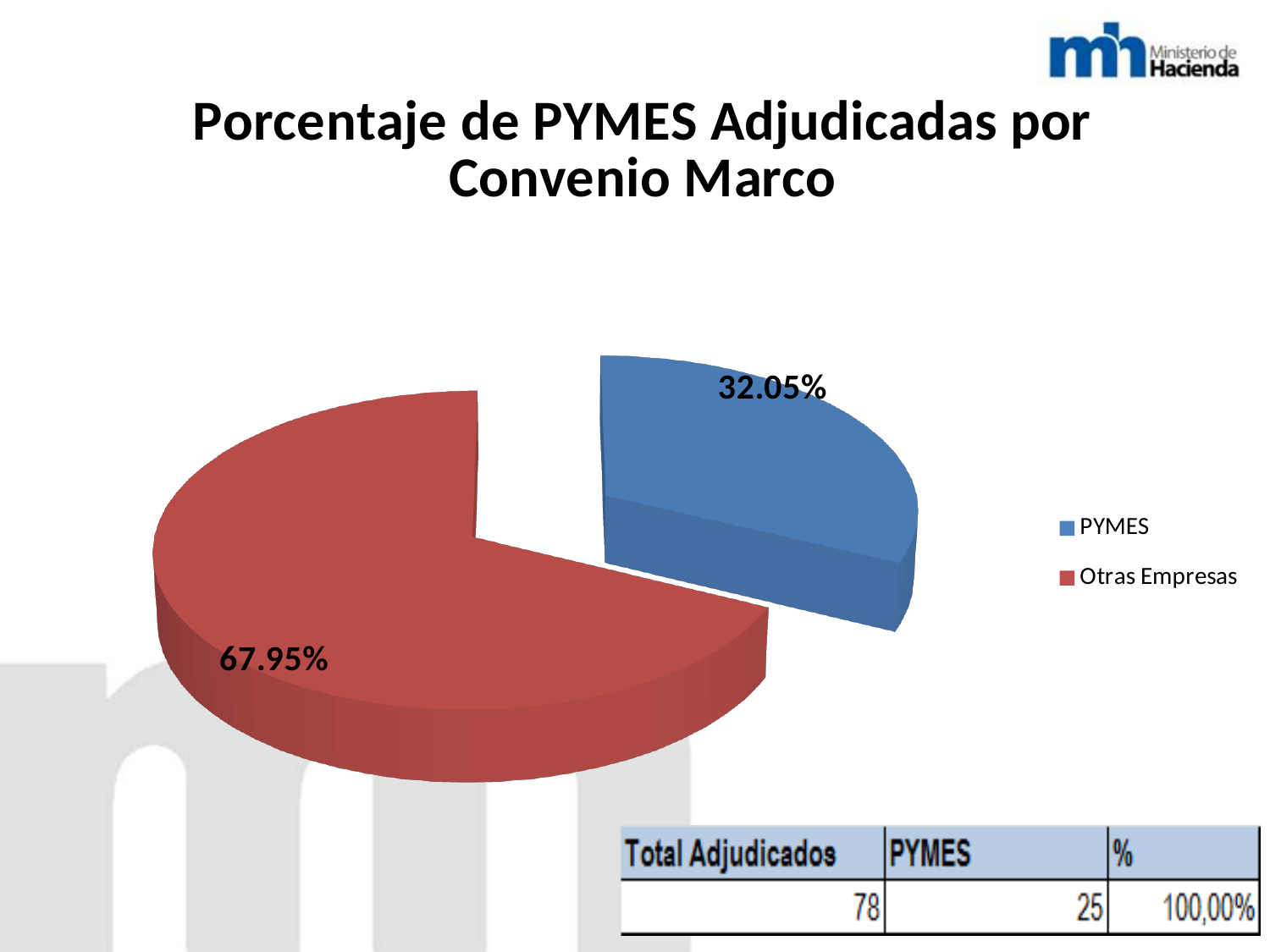
What percentage of the pie does the PYMES slice represent? 32.05% Which category has the largest share of the pie? Otras Empresas Which category has the smallest share of the pie? PYMES What is the title of the slide above the pie chart? Porcentaje de PYMES Adjudicadas por Convenio Marco How many entries does the legend list? 2 What percentage of the pie does the Otras Empresas slice represent? 67.95% What is the difference in percentage points between the Otras Empresas slice and the PYMES slice? 35.9 How many slices does the pie chart have? 2 Which slice is larger, PYMES or Otras Empresas? Otras Empresas Is the share for PYMES greater or less than 50%? less What type of chart is shown on the slide? pie chart What colour is the PYMES slice? blue